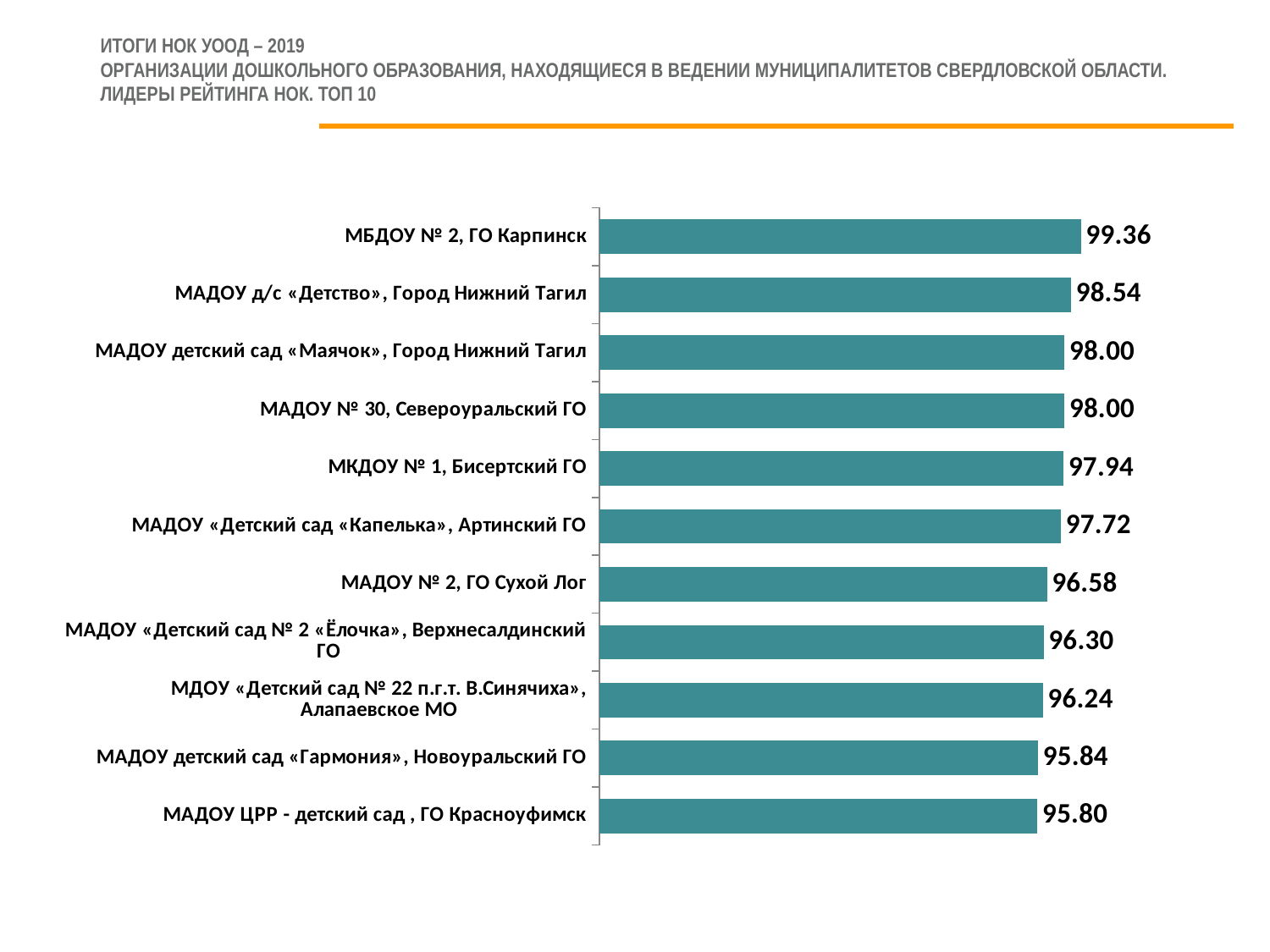
Which two organisations share the value 98.00? МАДОУ детский сад «Маячок», Город Нижний Тагил and МАДОУ № 30, Североуральский ГО Which has a larger value: МАДОУ № 2, ГО Сухой Лог or МАДОУ детский сад «Гармония», Новоуральский ГО? МАДОУ № 2, ГО Сухой Лог What is the value for МБДОУ № 2, ГО Карпинск? 99.36 Which organisation has the highest value? МБДОУ № 2, ГО Карпинск What is the difference between the values for МБДОУ № 2, ГО Карпинск and МАДОУ ЦРР - детский сад, ГО Красноуфимск? 3.56 What is the value for МАДОУ № 2, ГО Сухой Лог? 96.58 What kind of chart is shown on the slide? Bar chart How many organisations are shown in the chart? 11 What is the value for МАДОУ ЦРР - детский сад, ГО Красноуфимск? 95.80 What is the value for МАДОУ д/с «Детство», Город Нижний Тагил? 98.54 What is the difference between the values for МКДОУ № 1, Бисертский ГО and МАДОУ «Детский сад «Капелька», Артинский ГО? 0.22 Which organisation has the lowest value? МАДОУ ЦРР - детский сад, ГО Красноуфимск